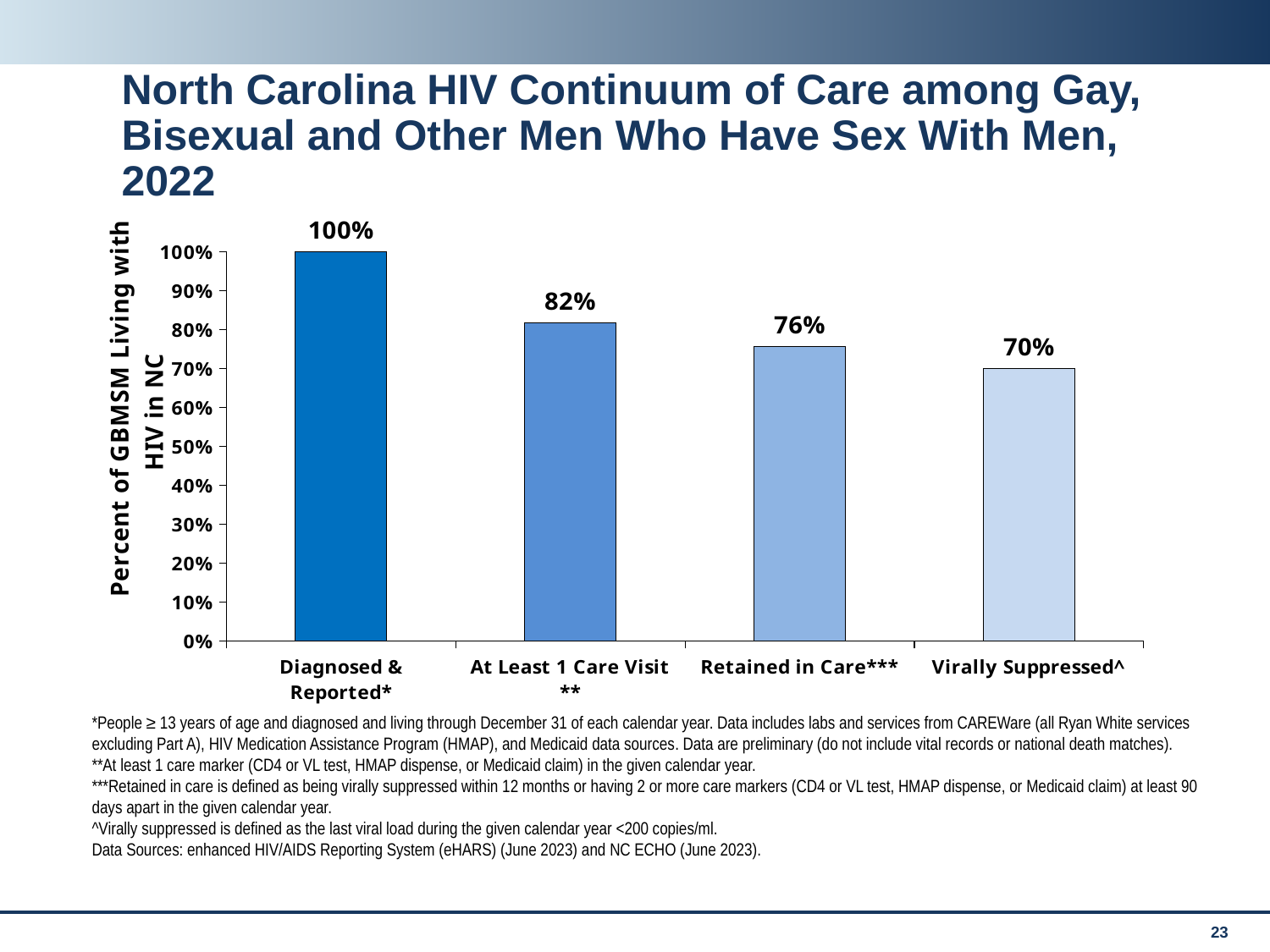
What is the value for Virally Suppressed? 70% What is the value for Diagnosed & Reported? 100% Which is larger, the value for Retained in Care or the value for Virally Suppressed? Retained in Care Which category has the lowest value? Virally Suppressed Which category has the highest value? Diagnosed & Reported What percentage of GBMSM living with HIV in NC had at least 1 care visit? 82% What is the difference between the Diagnosed & Reported value and the Virally Suppressed value? 30% Do the values rise or fall from left to right along the x axis? Fall How many categories are shown on the x axis? 4 What is the value for Retained in Care? 76% What kind of chart is shown on the slide? Bar chart What is the difference between At Least 1 Care Visit and Retained in Care? 6%